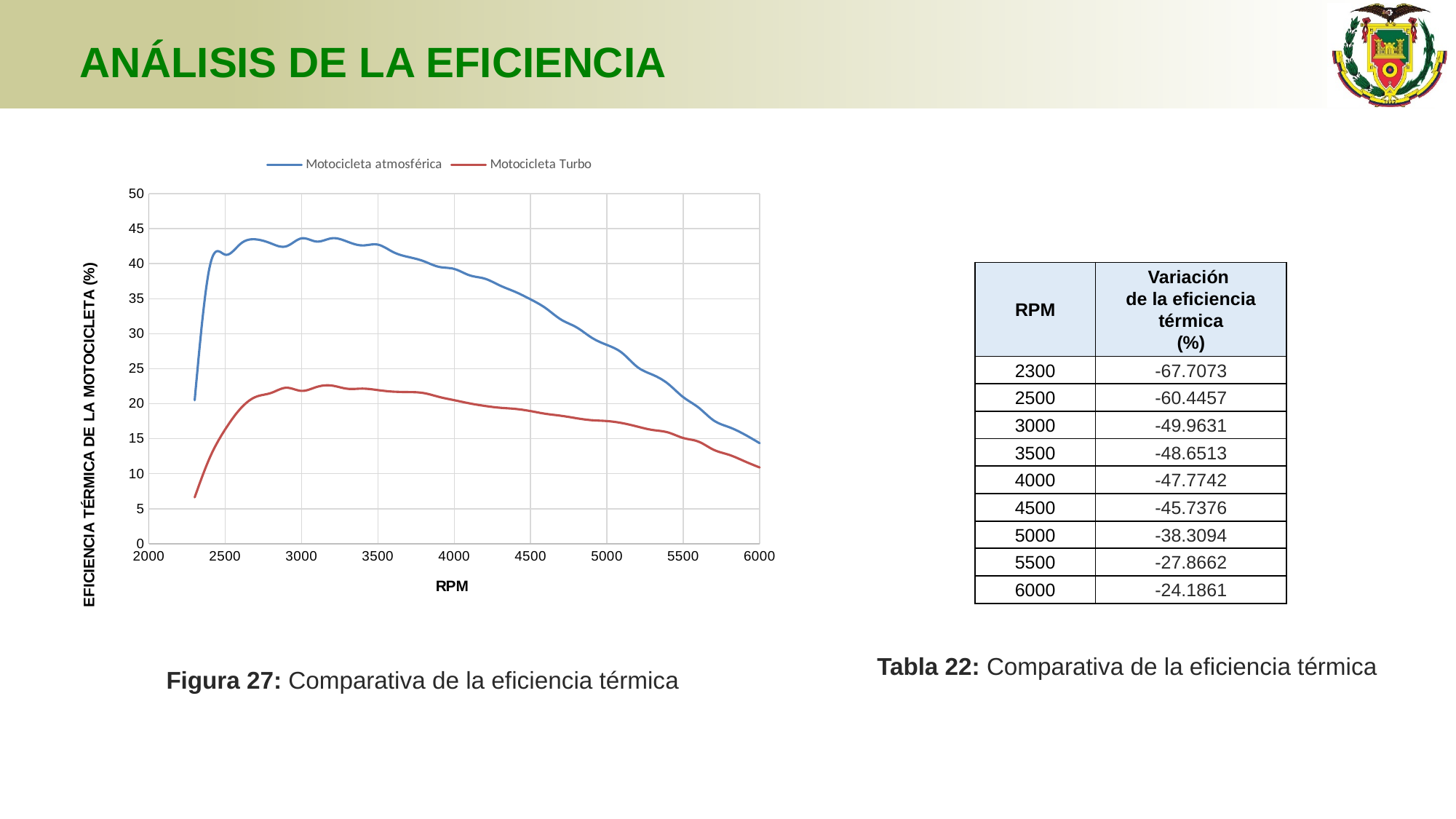
At 4000 RPM, which series has the higher thermal efficiency? Motocicleta atmosférica How many series does the legend of the chart list? 2 What kind of chart is shown in Figura 27? line chart Is the value for Motocicleta atmosférica at 5000 RPM greater or less than 25? greater Between 3500 and 6000 RPM, does the Motocicleta atmosférica line rise or fall? fall Is the value for Motocicleta Turbo at 3000 RPM greater or less than 25? less Is the value for Motocicleta atmosférica at 6000 RPM greater or less than 20? less What are the two series named in the chart legend? Motocicleta atmosférica and Motocicleta Turbo What is the title of the vertical axis of the chart? EFICIENCIA TÉRMICA DE LA MOTOCICLETA (%)